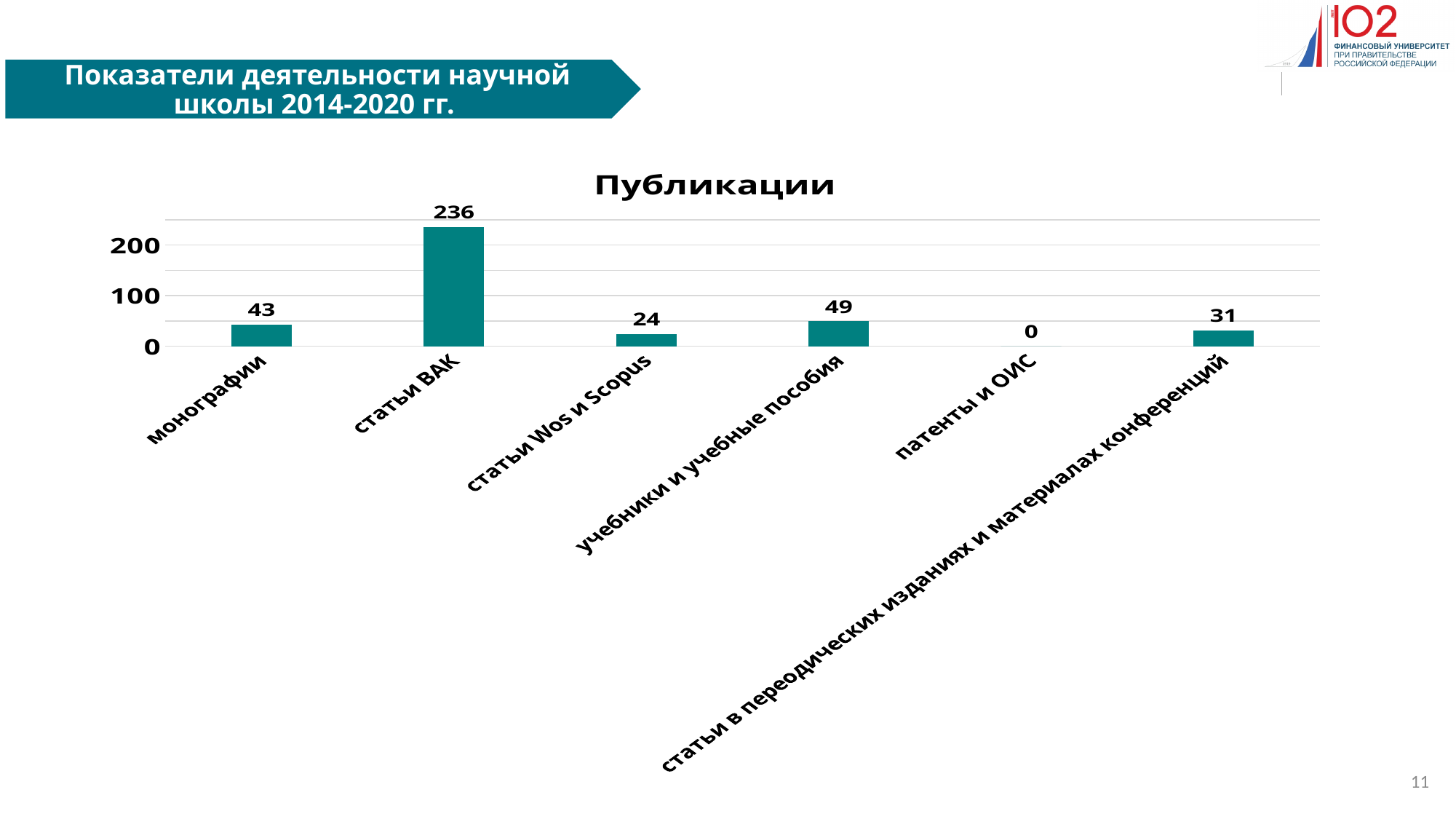
What is the value for статьи Wos и Scopus? 24 Is the value for учебники и учебные пособия greater or less than 100? less Which category has the highest value? статьи ВАК What is the title of the chart? Публикации What kind of chart is shown? bar chart How many categories are shown in the chart? 6 What is the value for монографии? 43 What is the value for статьи ВАК? 236 What is the difference between статьи ВАК and учебники и учебные пособия? 187 Which category has the lowest value? патенты и ОИС What is the value for патенты и ОИС? 0 Which is larger: монографии or статьи в переодических изданиях и материалах конференций? монографии